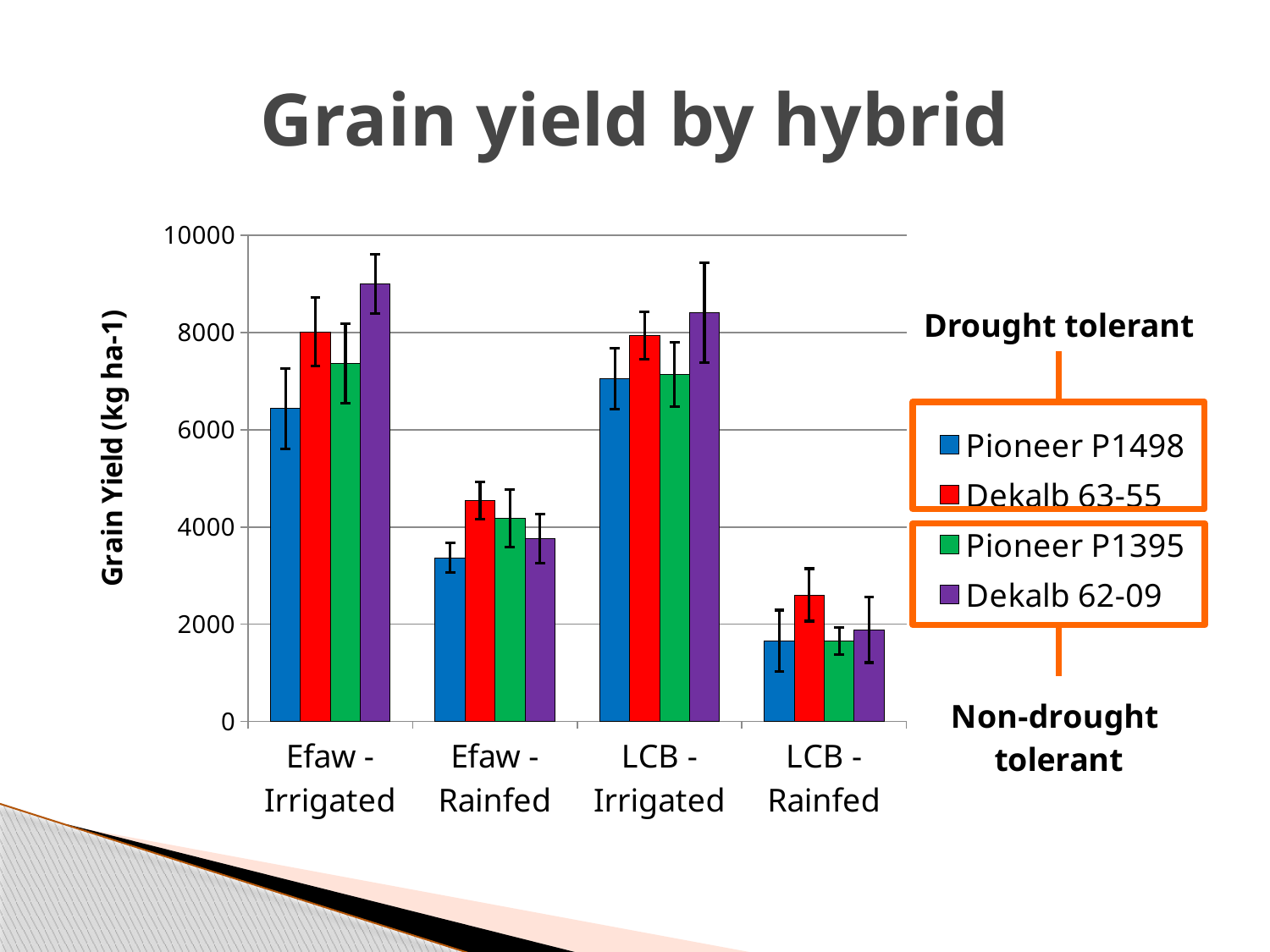
Is the grain yield for Dekalb 62-09 at Efaw - Irrigated greater or less than 8000? greater How many site-treatment categories are shown on the x axis? 4 What is the title of the y axis? Grain Yield (kg ha-1) How many series does the legend list? 4 Which series has the highest bar in the Efaw - Rainfed category? Dekalb 63-55 Which series has the highest bar in the Efaw - Irrigated category? Dekalb 62-09 In the Efaw - Irrigated category, which is larger: the yield for Dekalb 63-55 or for Pioneer P1498? Dekalb 63-55 For Dekalb 62-09, which category has the larger yield: Efaw - Irrigated or LCB - Irrigated? Efaw - Irrigated Which category has the lowest grain yields overall? LCB - Rainfed Is the grain yield for Pioneer P1498 at Efaw - Rainfed greater or less than 4000? less What kind of chart is shown on the slide? bar chart Is the grain yield for Dekalb 63-55 at LCB - Rainfed greater or less than 2000? greater